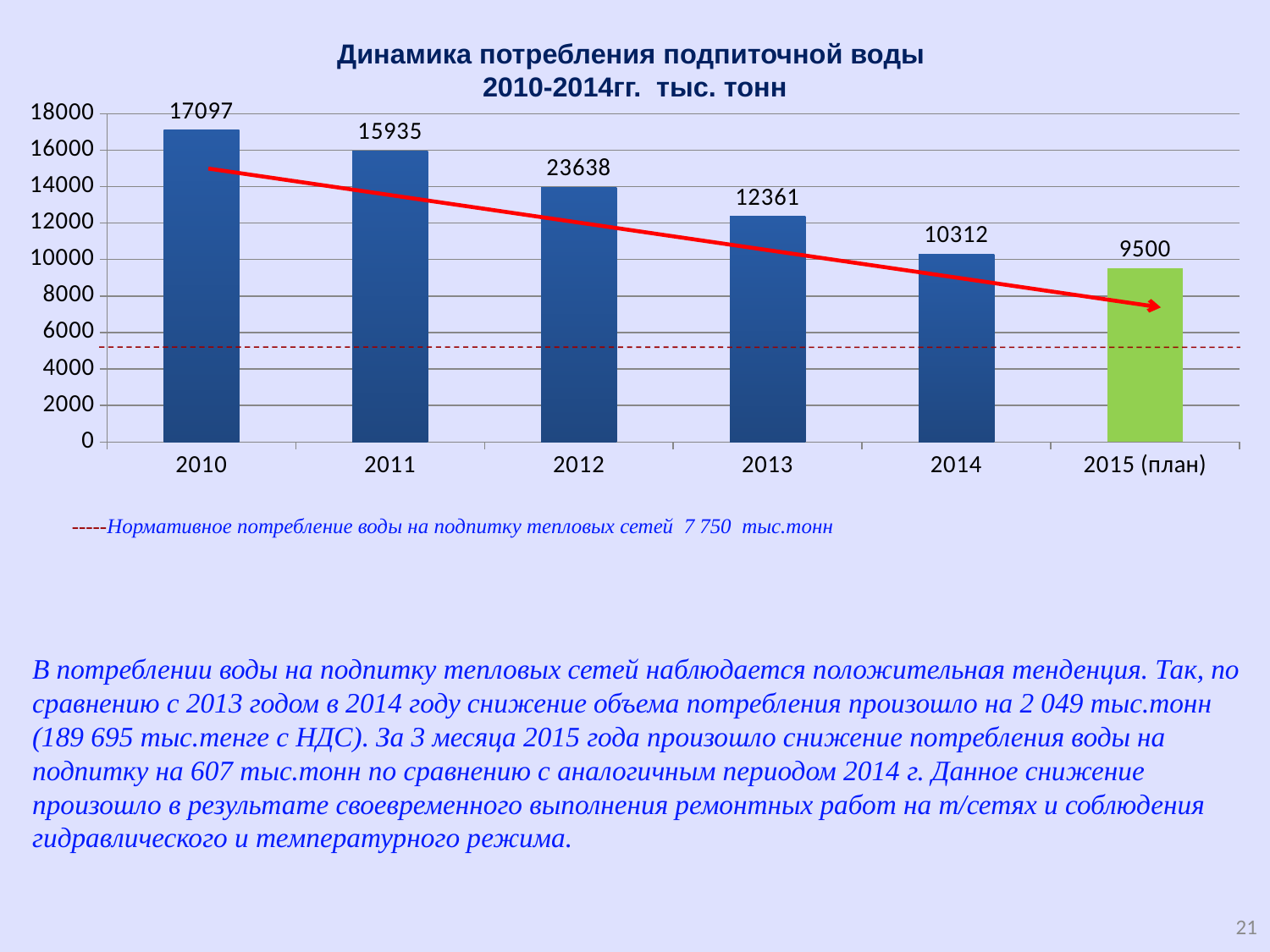
How many categories are shown on the x axis? 6 What is the value for 2013? 12361 Is the value for 2014 greater or less than 12000? less Do the bar heights rise or fall from 2010 to 2015 (план)? fall What is the difference between the values for 2013 and 2014? 2049 What is the value for 2015 (план)? 9500 Which is larger, the value for 2011 or the value for 2013? 2011 What is the difference between the values for 2010 and 2011? 1162 What is the value for 2014? 10312 What kind of chart is this? bar chart What is the value for 2011? 15935 What is the value for 2010? 17097